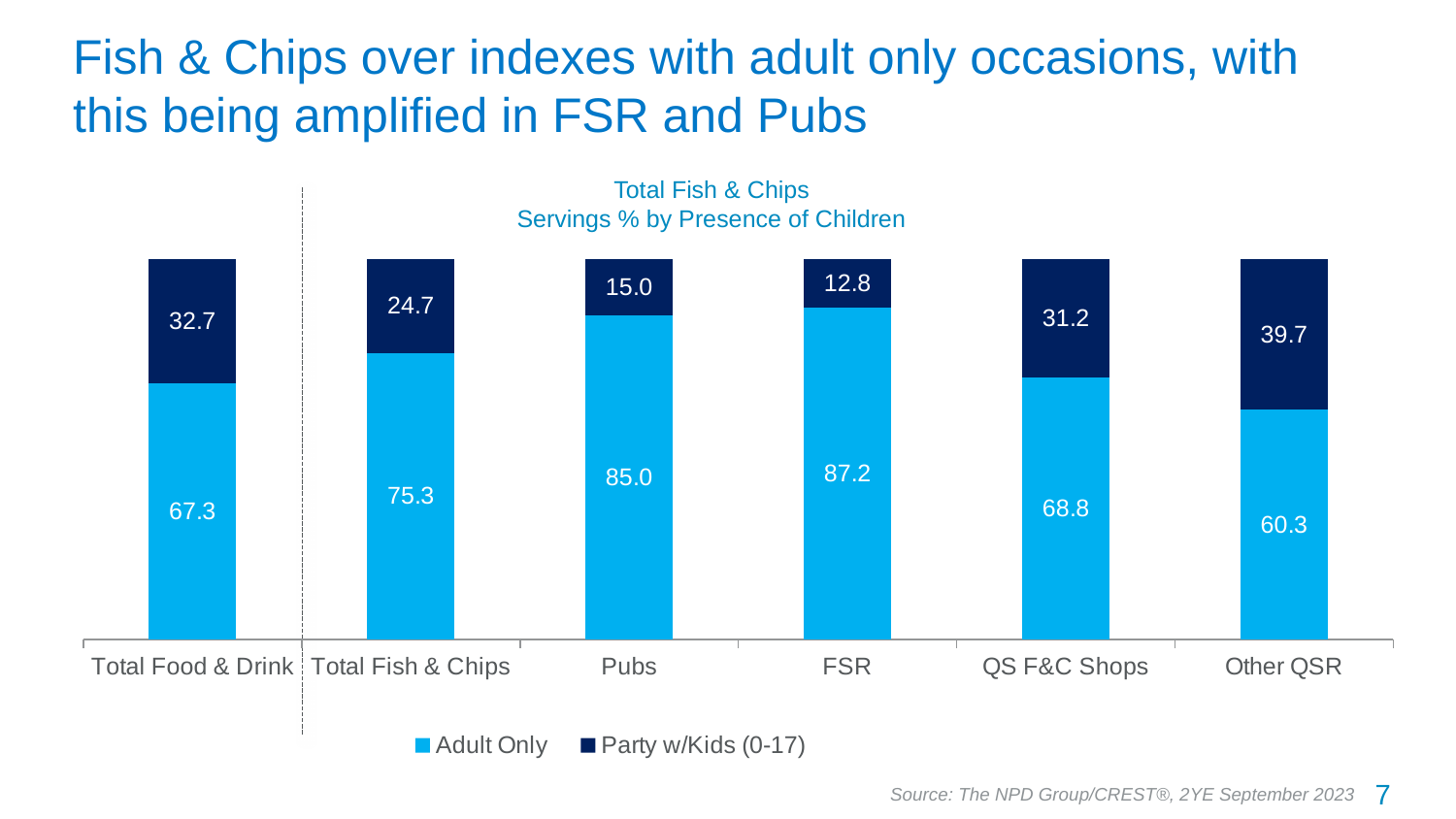
Which is larger, the Party w/Kids (0-17) value for QS F&C Shops or for Total Food & Drink? Total Food & Drink How many series does the legend list? 2 What is the Adult Only value for Total Fish & Chips? 75.3 What is the difference between the Adult Only values for Pubs and Total Food & Drink? 17.7 What is the total of the stacked bar for Other QSR? 100.0 What is the title of the chart? Total Fish & Chips Servings % by Presence of Children Which category has the lowest Party w/Kids (0-17) value? FSR What kind of chart is shown? Stacked bar chart What is the Adult Only value for FSR? 87.2 Which category has the highest Adult Only value? FSR What is the Party w/Kids (0-17) value for Other QSR? 39.7 How many categories are shown on the x axis? 6